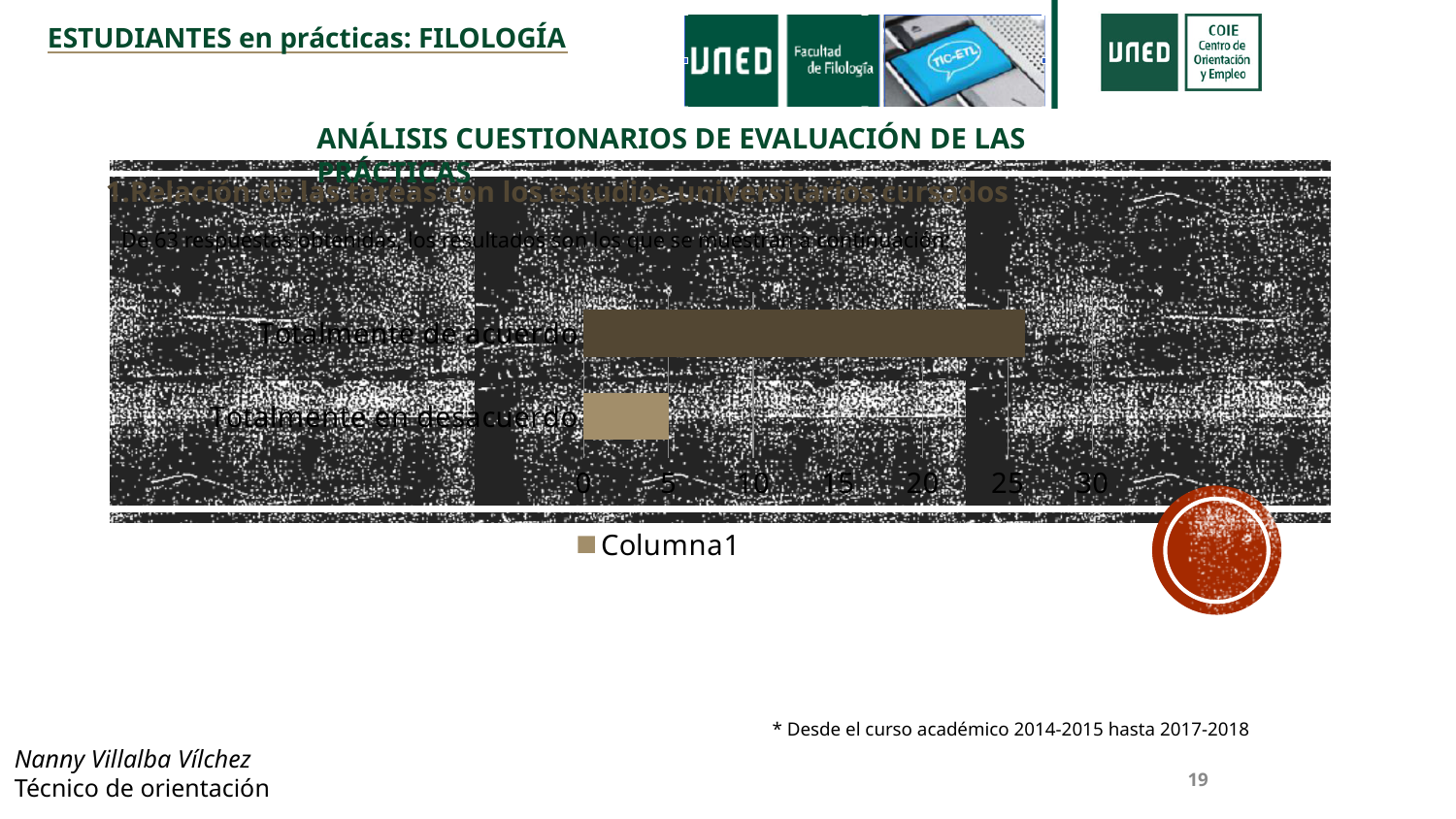
Which is larger, the value for Totalmente de acuerdo or the value for Totalmente en desacuerdo? Totalmente de acuerdo Is the value for Totalmente de acuerdo greater or less than 15? greater Is the value for Totalmente de acuerdo greater or less than 20? greater Is the value for Totalmente en desacuerdo greater or less than 10? less What is the name of the series shown in the chart legend? Columna1 Which category has the highest value in the chart? Totalmente de acuerdo How many categories does the bar chart show? 2 What kind of chart is shown on the slide? bar chart How many series does the chart legend list? 1 What is the highest tick value shown on the horizontal axis of the chart? 30 Which category has the lowest value in the chart? Totalmente en desacuerdo